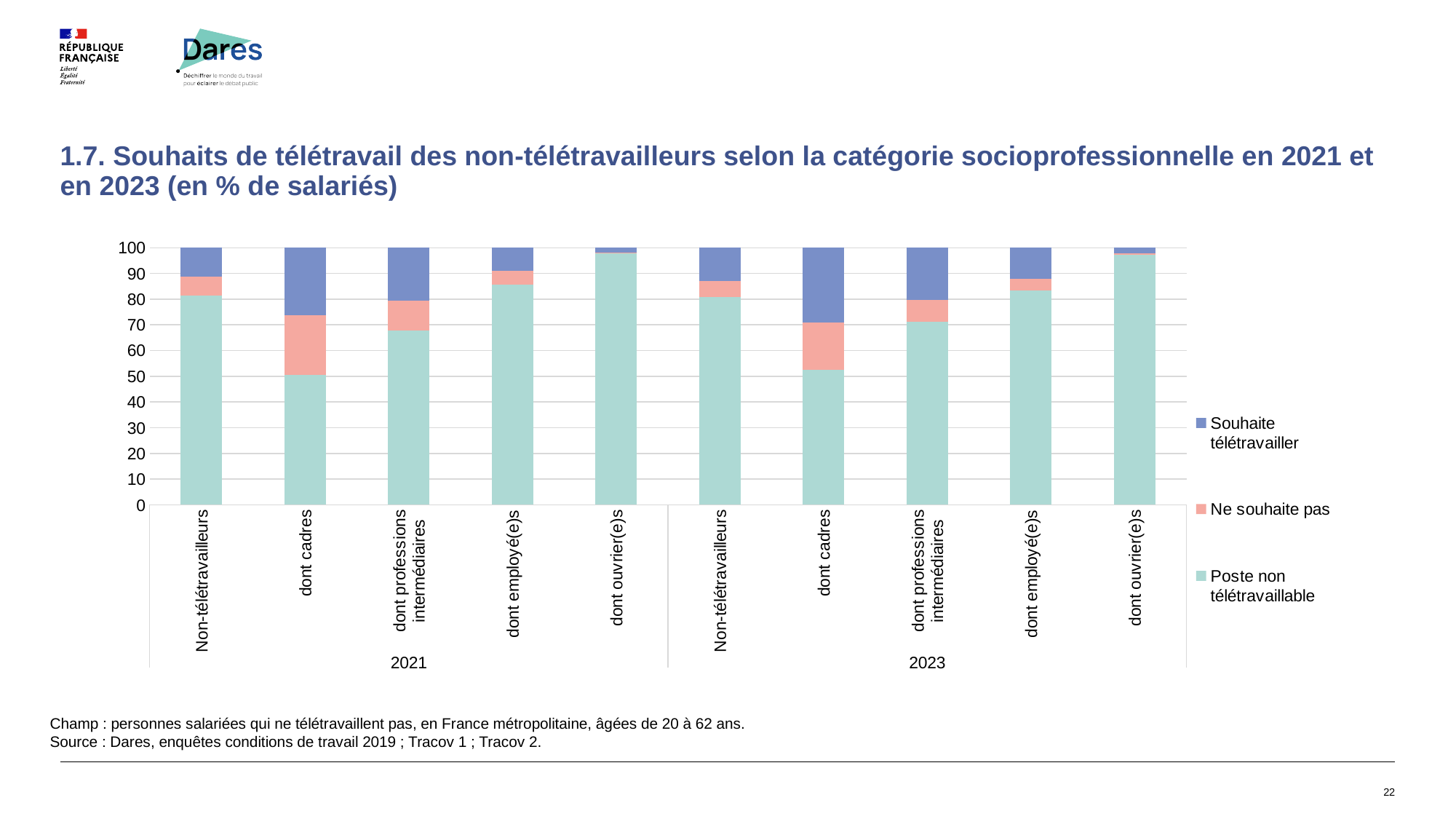
In 2023, which category has the largest 'Poste non télétravaillable' segment? dont ouvrier(e)s In 2023, is the 'Souhaite télétravailler' segment larger for 'dont cadres' or for 'dont employé(e)s'? dont cadres Which two years are compared in the chart? 2021 and 2023 In 2021, which category has the smallest 'Poste non télétravaillable' segment? dont cadres What kind of chart is shown on the slide? Stacked bar chart Is the 'Poste non télétravaillable' value for 'dont professions intermédiaires' in 2023 greater or less than 60? greater How many series does the legend list? 3 Is the 'Poste non télétravaillable' value for 'dont ouvrier(e)s' in 2021 greater or less than 90? greater Is the 'Poste non télétravaillable' value for 'dont cadres' in 2021 greater or less than 60? less Which legend entry is shown in blue? Souhaite télétravailler How many stacked bars are plotted in the chart? 10 In 2021, is the 'Ne souhaite pas' segment larger for 'dont cadres' or for 'dont ouvrier(e)s'? dont cadres